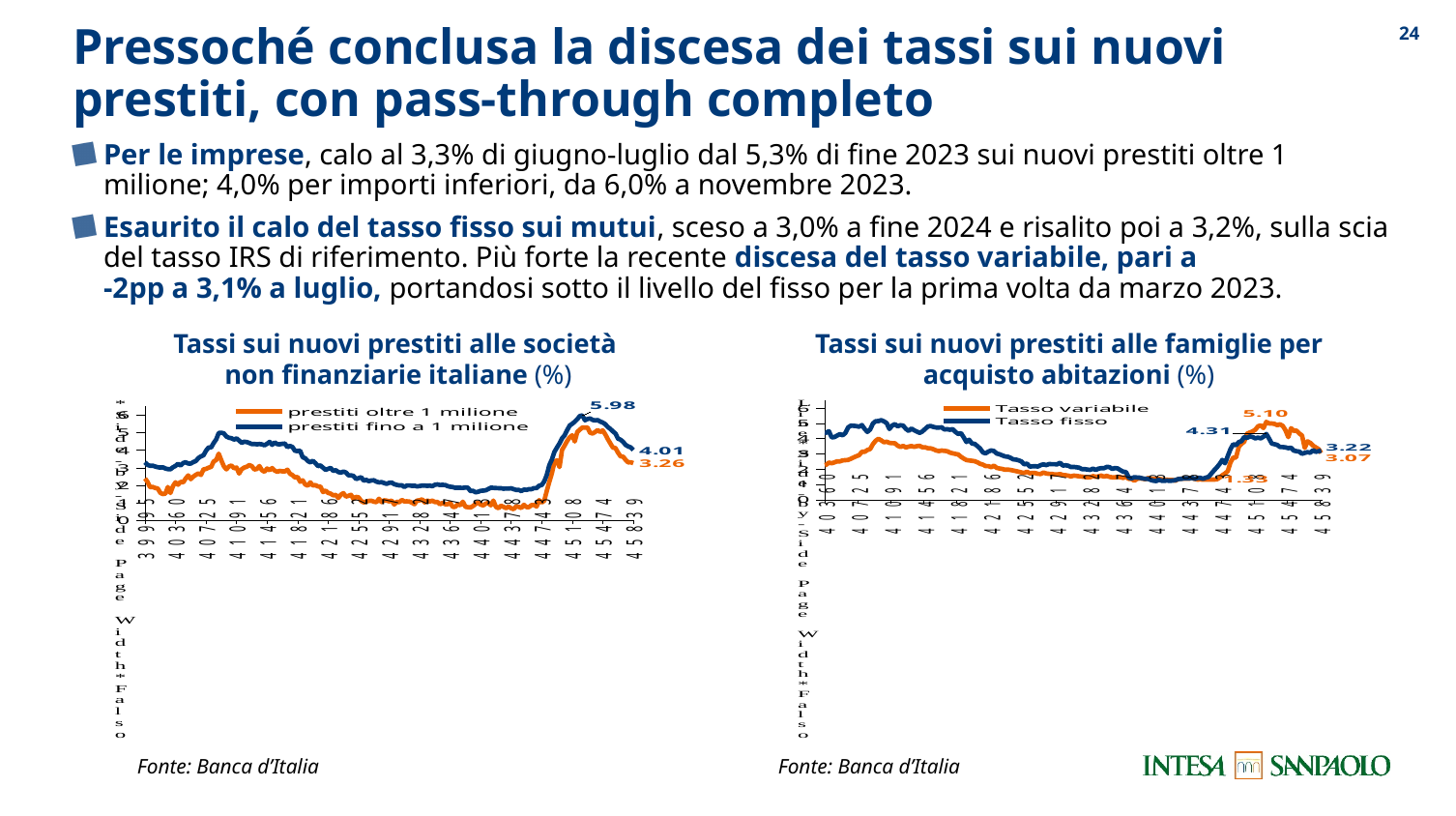
In the left chart, 'Tassi sui nuovi prestiti alle società non finanziarie italiane', what is the labelled peak value of the 'prestiti fino a 1 milione' series? 5.98 In the left chart, 'Tassi sui nuovi prestiti alle società non finanziarie italiane', which series has the higher latest labelled value, 'prestiti oltre 1 milione' or 'prestiti fino a 1 milione'? prestiti fino a 1 milione In the right chart, 'Tassi sui nuovi prestiti alle famiglie per acquisto abitazioni', what are the two series named in the legend? Tasso variabile and Tasso fisso In the left chart, 'Tassi sui nuovi prestiti alle società non finanziarie italiane', what is the latest labelled value for 'prestiti fino a 1 milione'? 4.01 In the right chart, 'Tassi sui nuovi prestiti alle famiglie per acquisto abitazioni', what is the latest labelled value for 'Tasso fisso'? 3.22 In the left chart, 'Tassi sui nuovi prestiti alle società non finanziarie italiane', how many series does the legend list? 2 In the right chart, 'Tassi sui nuovi prestiti alle famiglie per acquisto abitazioni', how many series does the legend list? 2 What kind of chart is the left chart, 'Tassi sui nuovi prestiti alle società non finanziarie italiane'? line chart In the left chart, 'Tassi sui nuovi prestiti alle società non finanziarie italiane', what is the latest labelled value for 'prestiti oltre 1 milione'? 3.26 In the right chart, 'Tassi sui nuovi prestiti alle famiglie per acquisto abitazioni', what is the labelled peak value of the 'Tasso variabile' series? 5.10 In the right chart, 'Tassi sui nuovi prestiti alle famiglie per acquisto abitazioni', what is the latest labelled value for 'Tasso variabile'? 3.07 In the left chart, 'Tassi sui nuovi prestiti alle società non finanziarie italiane', what is the difference between the latest labelled values of 'prestiti fino a 1 milione' (4.01) and 'prestiti oltre 1 milione' (3.26)? 0.75